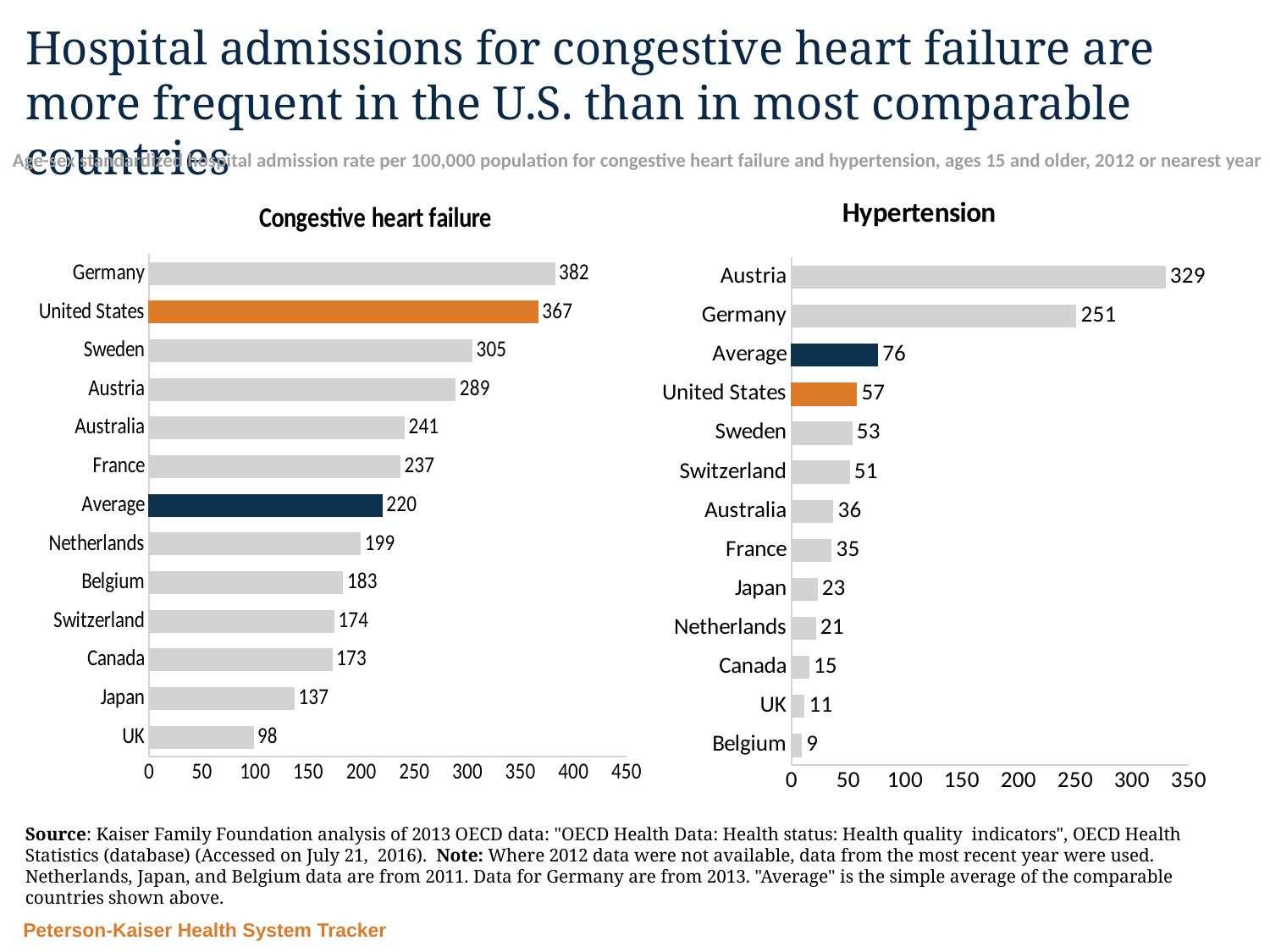
In the Congestive heart failure chart, what is the difference between Germany and the United States? 15 In the Hypertension chart, which category has the lowest value? Belgium In the Hypertension chart, what is the difference between the Average and the United States? 19 How many categories are shown in the Congestive heart failure chart? 13 In the Congestive heart failure chart, what is the value for the Average? 220 In the Congestive heart failure chart, which is larger, the value for Sweden or the value for Austria? Sweden In the Hypertension chart, is the value for Germany greater or less than 200? greater What kind of chart is the Hypertension chart? Bar chart In the Hypertension chart, what colour is the bar for the United States? Orange In the Congestive heart failure chart, what is the value for the United States? 367 In the Congestive heart failure chart, which category has the highest value? Germany In the Hypertension chart, what is the value for Austria? 329